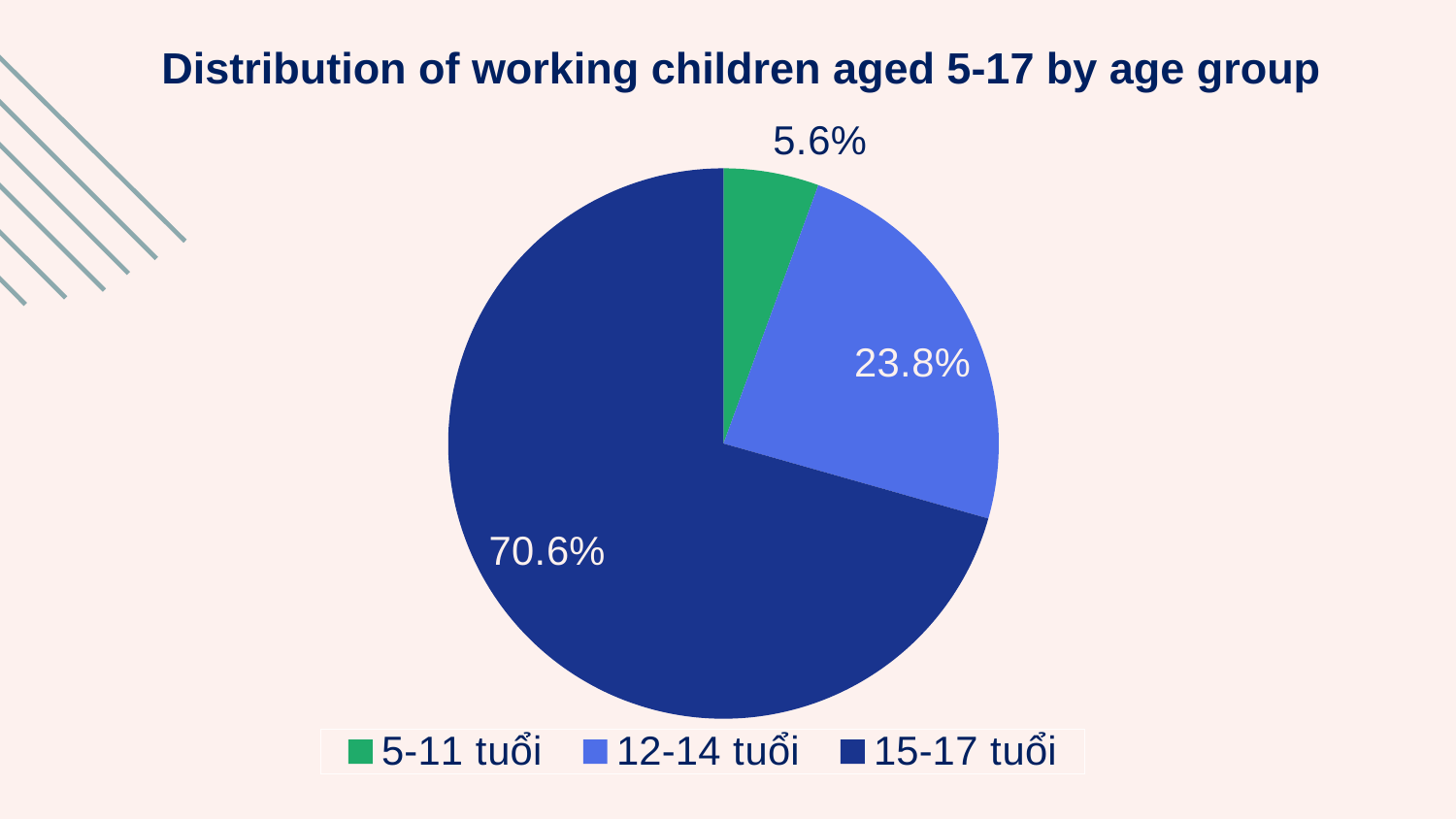
What share of working children are in the 12-14 tuổi age group? 23.8% Which colour represents the 5-11 tuổi age group in the legend? Green Which is larger, the share for 12-14 tuổi or the share for 5-11 tuổi? 12-14 tuổi Which age group has the smallest share of working children? 5-11 tuổi How many entries does the legend list? 3 What is the title of the chart? Distribution of working children aged 5-17 by age group What share of working children are in the 15-17 tuổi age group? 70.6% How many age groups are shown in the pie chart? 3 What share of working children are in the 5-11 tuổi age group? 5.6% What is the difference in percentage points between the 15-17 tuổi and 12-14 tuổi shares? 46.8 Which age group has the largest share of working children? 15-17 tuổi What kind of chart is shown on the slide? Pie chart